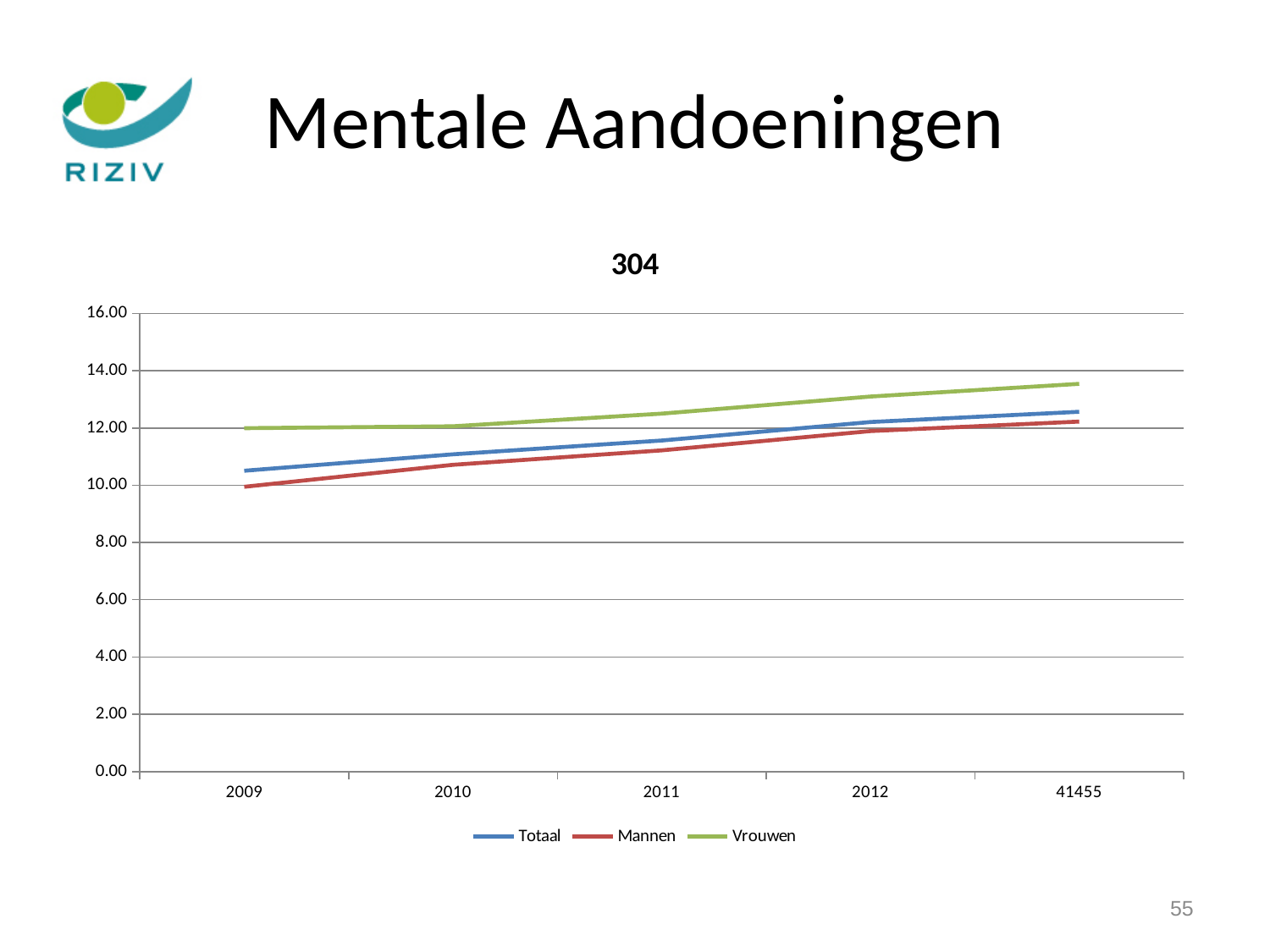
Which series has the highest value at the last x-axis point (41455)? Vrouwen Is the value for Totaal in 2009 greater or less than 10.00? greater How many points are plotted along the x axis for each series? 5 Does the Vrouwen line rise or fall from 2009 to the last point? rise Is the value for Vrouwen at 41455 greater or less than 14.00? less Which series has the lowest value in 2009? Mannen Is the value for Mannen in 2010 greater or less than 12.00? less In 2011, which is larger: the value for Vrouwen or the value for Mannen? Vrouwen What is the title of the chart? 304 Does the Mannen line rise or fall across the x axis? rise How many series does the legend list? 3 What kind of chart is shown on the slide? line chart